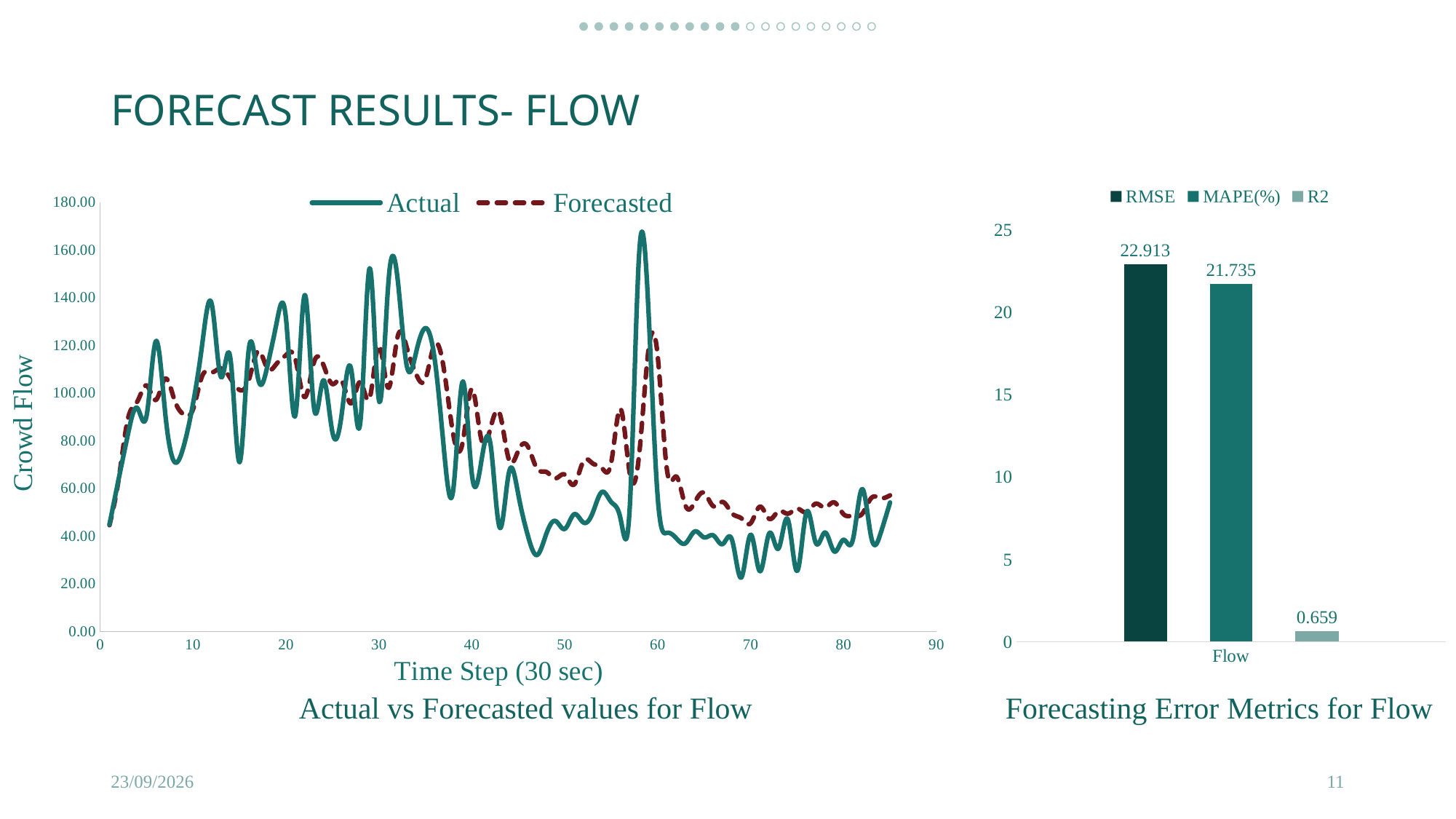
In the Forecasting Error Metrics for Flow chart, what is the difference between the RMSE and MAPE(%) values? 1.178 In the Forecasting Error Metrics for Flow chart, which metric has the highest value? RMSE In the Forecasting Error Metrics for Flow chart, what is the R2 value? 0.659 In the Forecasting Error Metrics for Flow chart, how many series does the legend list? 3 What kind of chart is the Actual vs Forecasted values for Flow chart? line chart In the Forecasting Error Metrics for Flow chart, what is the MAPE(%) value? 21.735 What kind of chart is the Forecasting Error Metrics for Flow chart? bar chart In the Forecasting Error Metrics for Flow chart, which metric has the lowest value? R2 In the Actual vs Forecasted values for Flow chart, what is the label of the y axis? Crowd Flow In the Actual vs Forecasted values for Flow chart, how many series does the legend list? 2 In the Forecasting Error Metrics for Flow chart, what is the RMSE value? 22.913